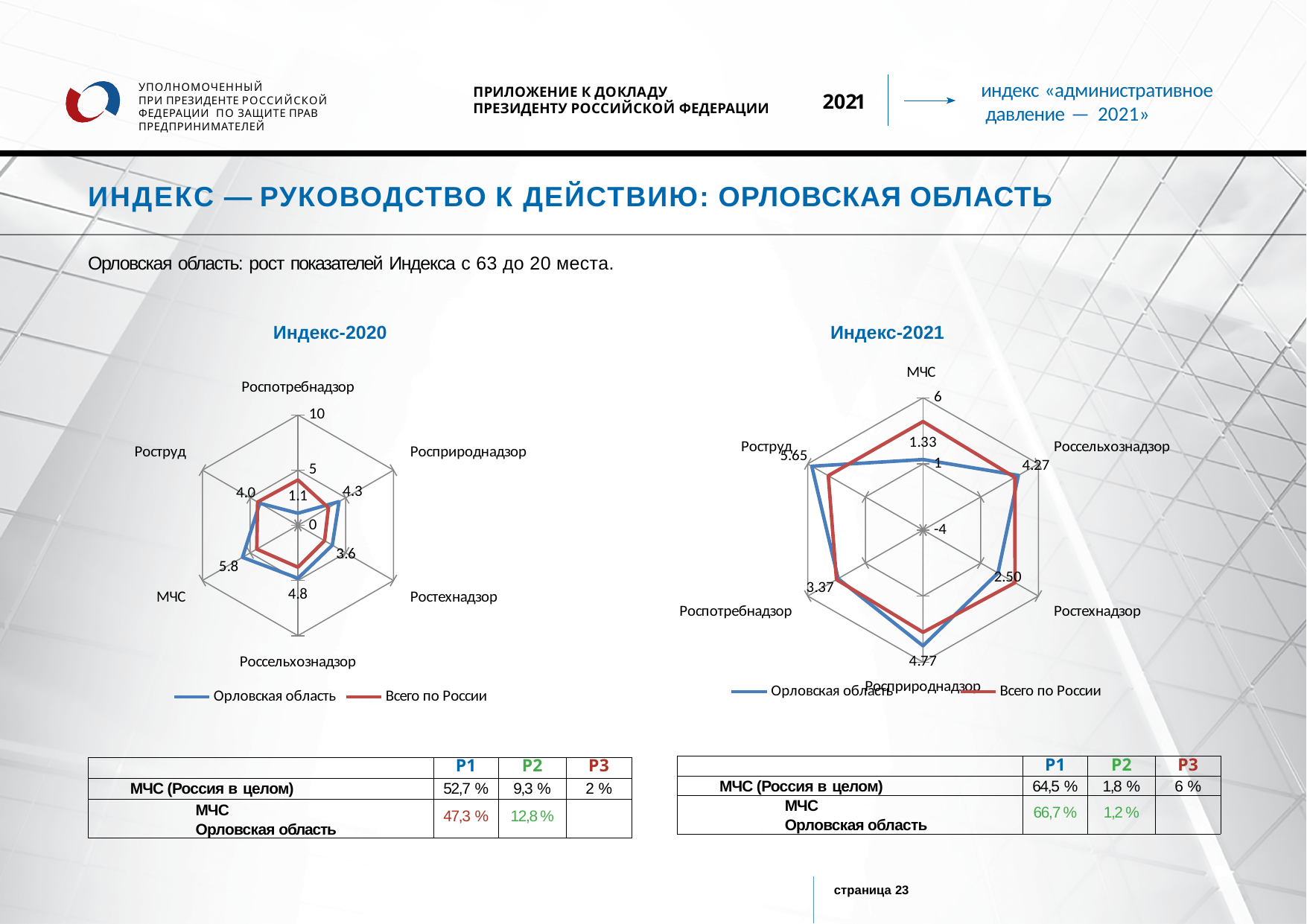
How many axes (categories) does the "Индекс-2020" radar chart have? 6 In the "Индекс-2021" chart, what value is labelled for Роструд? 5.65 How many series does the legend of the "Индекс-2021" chart list? 2 In the "Индекс-2021" chart, what value is labelled for МЧС? 1.33 In the "Индекс-2020" chart, what value is labelled for МЧС? 5.8 In the "Индекс-2021" chart, which series has the larger value on the МЧС axis, Орловская область or Всего по России? Всего по России In the "Индекс-2021" chart, what is the difference between the labelled values for Росприроднадзор and Ростехнадзор? 2.27 What kind of chart is the "Индекс-2020" chart? Radar chart In the "Индекс-2020" chart, which category has the lowest labelled value? Роспотребнадзор In the "Индекс-2020" chart, which category has the highest labelled value? МЧС In the "Индекс-2020" chart, what value is labelled for Роспотребнадзор? 1.1 In the "Индекс-2021" chart, which category has the highest labelled value? Роструд